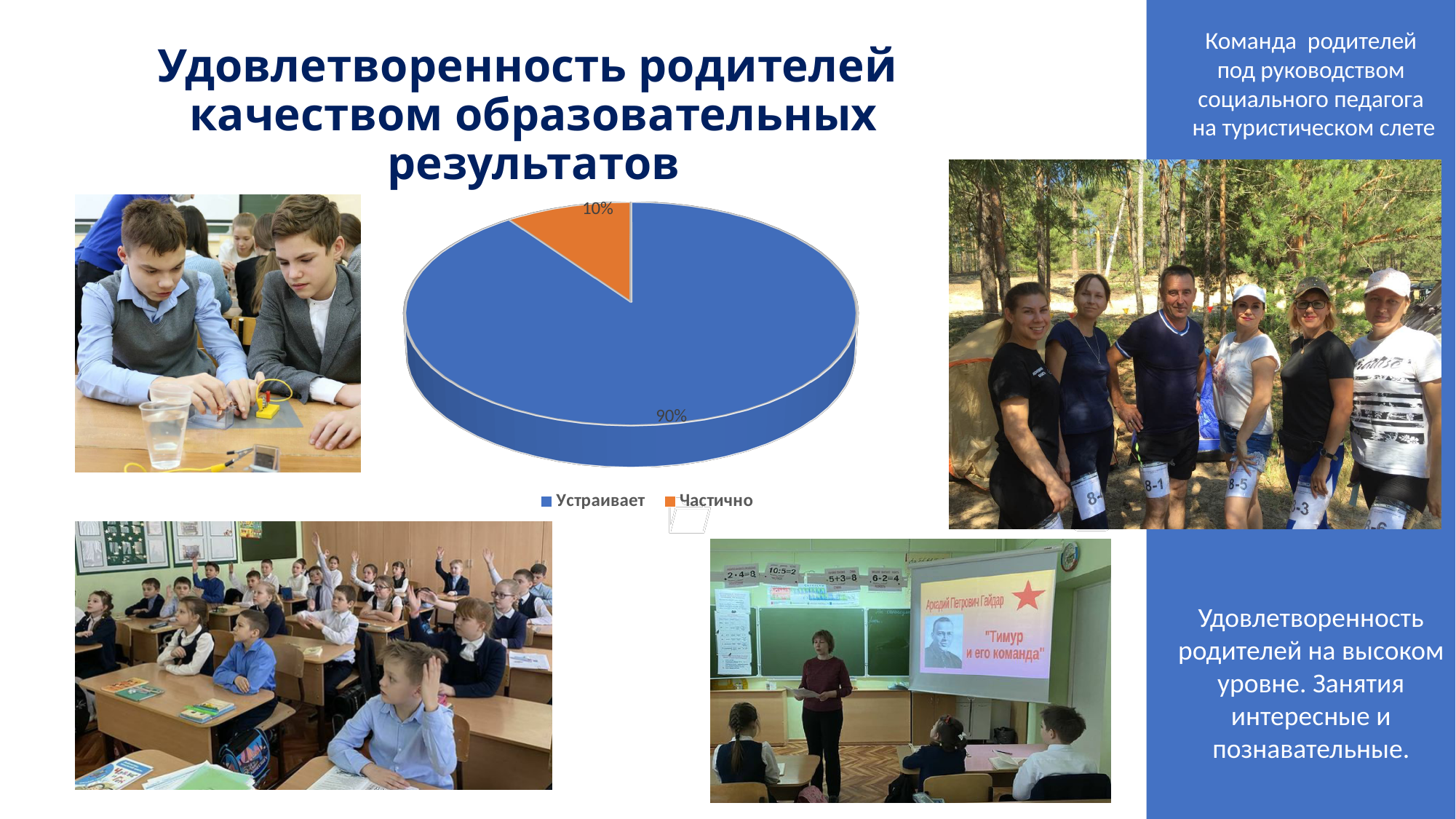
What is the difference in percentage points between the "Устраивает" and "Частично" slices? 80 What share of the pie does the "Частично" slice represent? 10% Which category has the largest slice in the pie chart? Устраивает What is the total of the two slice percentages shown on the pie chart? 100% What colour is the "Устраивает" slice in the pie chart? Blue Which is larger, the "Устраивает" slice or the "Частично" slice? Устраивает Which category has the smallest slice in the pie chart? Частично What share of the pie does the "Устраивает" slice represent? 90% What kind of chart is shown on the slide? Pie chart What colour is the "Частично" slice in the pie chart? Orange How many slices does the pie chart have? 2